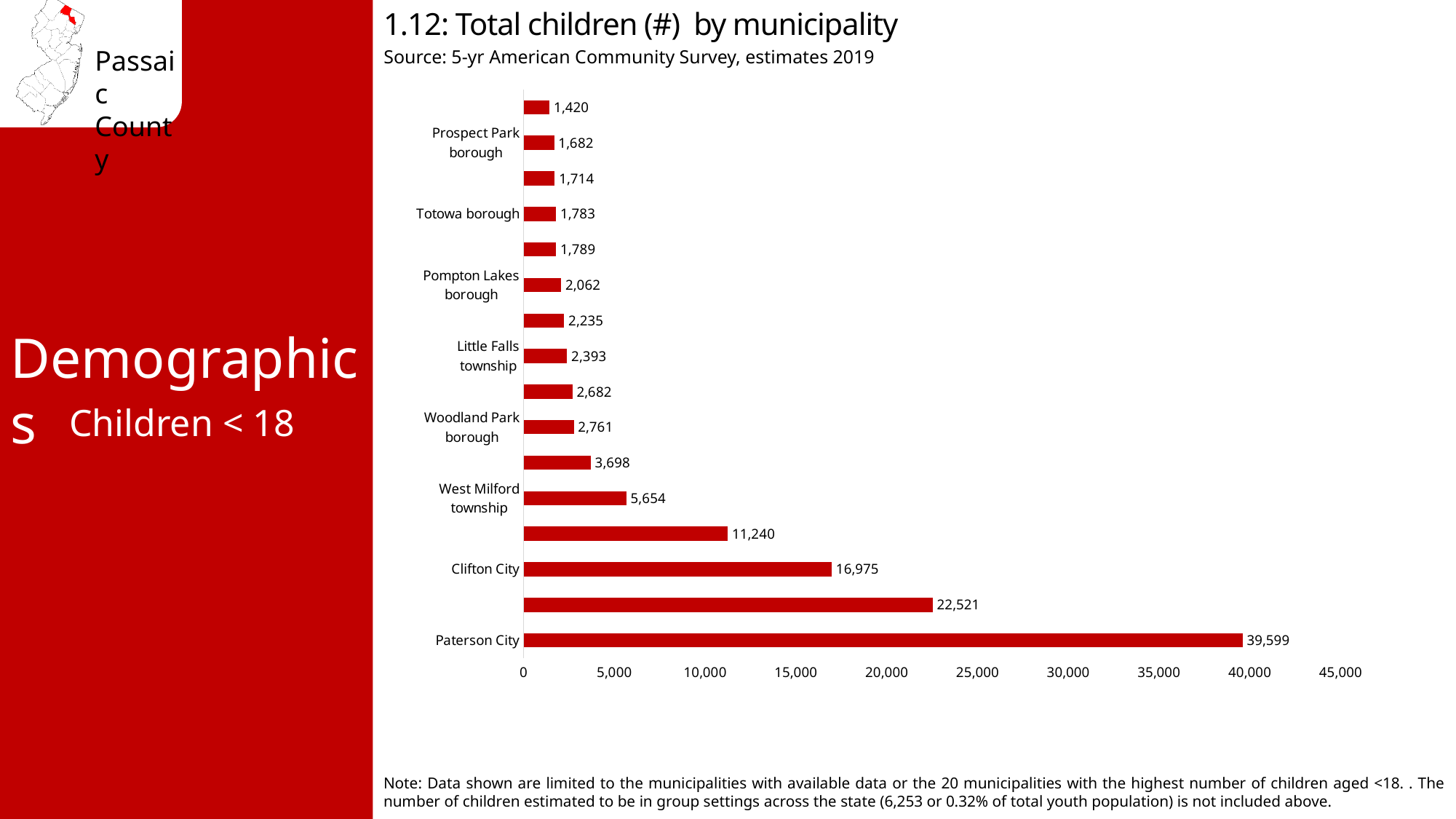
Which has more children, Woodland Park borough or Totowa borough? Woodland Park borough What is the total number of children for West Milford township? 5,654 Which municipality has the highest number of children? Paterson City What is the smallest value shown on the chart? 1,420 What is the total number of children for Clifton City? 16,975 What is the difference between the values for Paterson City and Clifton City? 22,624 What is the title of the chart? 1.12: Total children (#) by municipality How many bars are plotted on the chart? 16 Is the value for Clifton City greater or less than 15,000? greater What type of chart is shown on the slide? bar chart What is the total number of children for Paterson City? 39,599 What is the total number of children for Little Falls township? 2,393